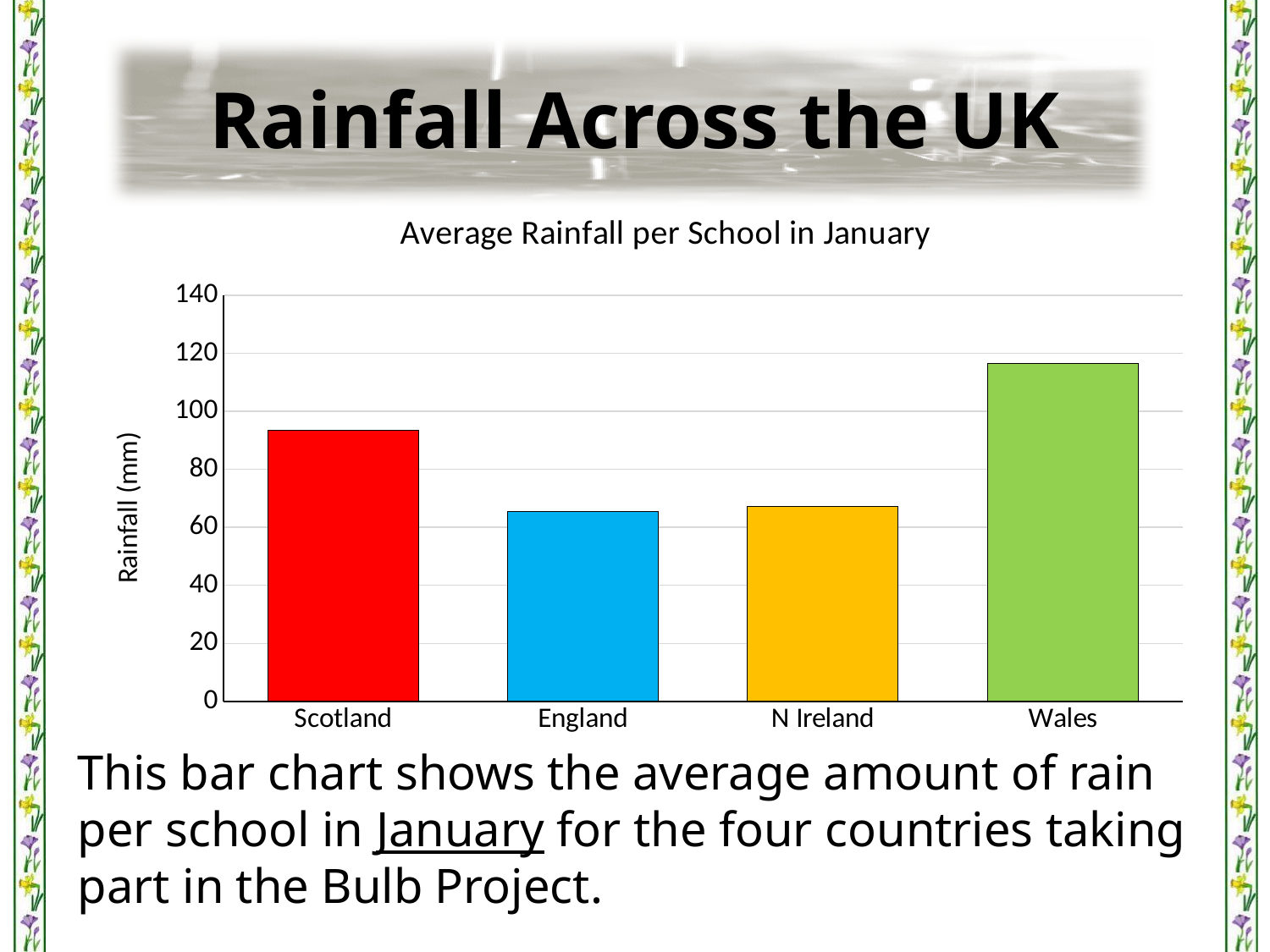
Is the value for Scotland greater or less than 100? less Which country has the highest average rainfall on the chart? Wales Which has the higher average rainfall, Wales or N Ireland? Wales Is the value for England greater or less than 80? less How many countries are shown on the chart? 4 Is the value for N Ireland greater or less than 60? greater What is the title of the chart? Average Rainfall per School in January What is the label on the vertical axis of the chart? Rainfall (mm) What kind of chart is shown on the slide? bar chart Which has the higher average rainfall, Scotland or England? Scotland